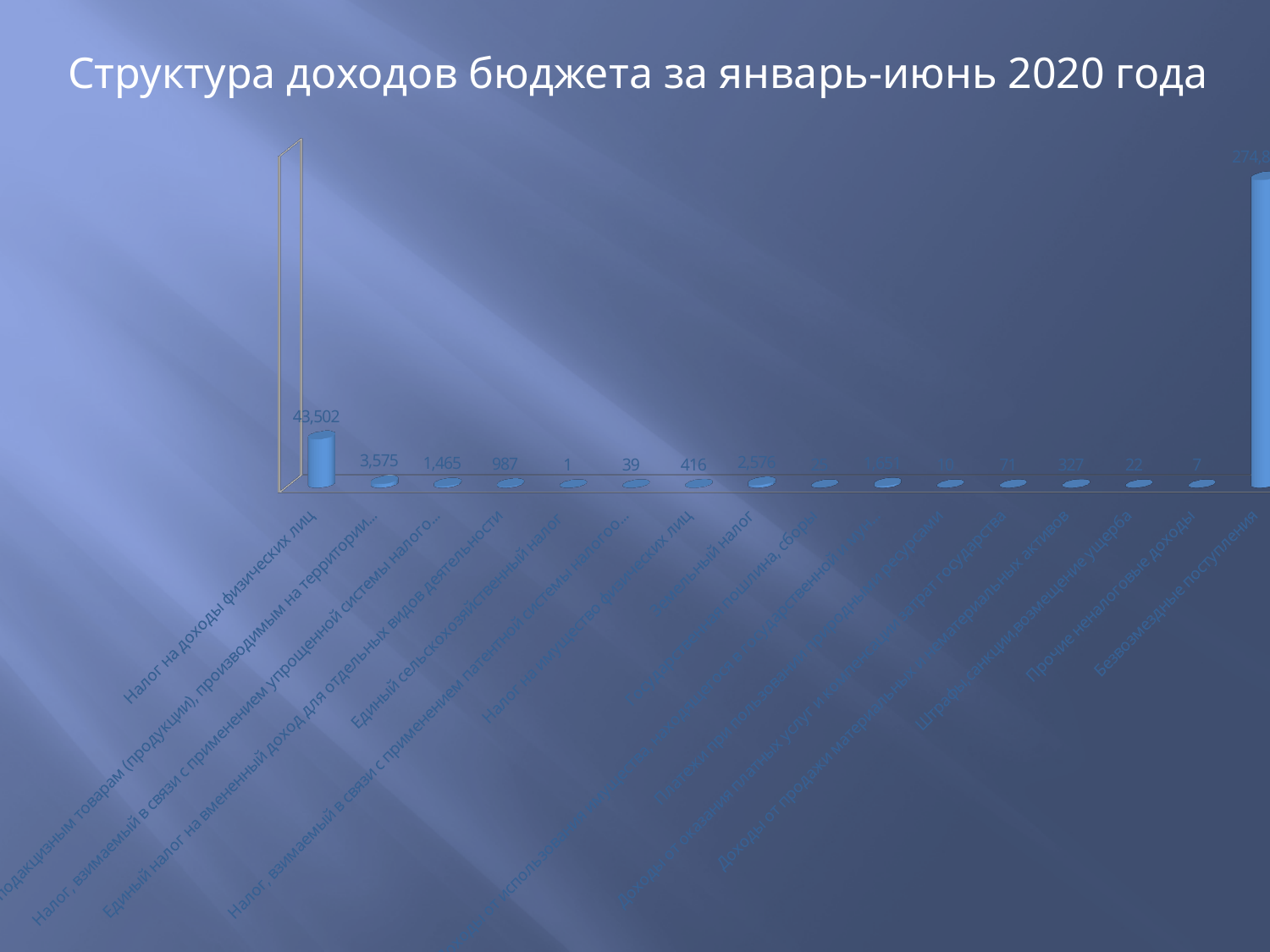
What kind of chart is shown on the slide? Bar chart What is the title of the chart? Структура доходов бюджета за январь-июнь 2020 года What is the value shown for Единый налог на вмененный доход для отдельных видов деятельности? 987 What is the value shown for Земельный налог? 2,576 What is the value shown for Прочие неналоговые доходы? 7 What is the difference between the values for Налог на доходы физических лиц and Земельный налог? 40,926 Which category has the highest value in the chart? Безвозмездные поступления What is the value shown for Налог на доходы физических лиц? 43,502 Which is larger: Земельный налог or Налог на имущество физических лиц? Земельный налог What is the value shown for Налог на имущество физических лиц? 416 What is the value shown for Штрафы, санкции, возмещение ущерба? 22 What is the value shown for Единый сельскохозяйственный налог? 1